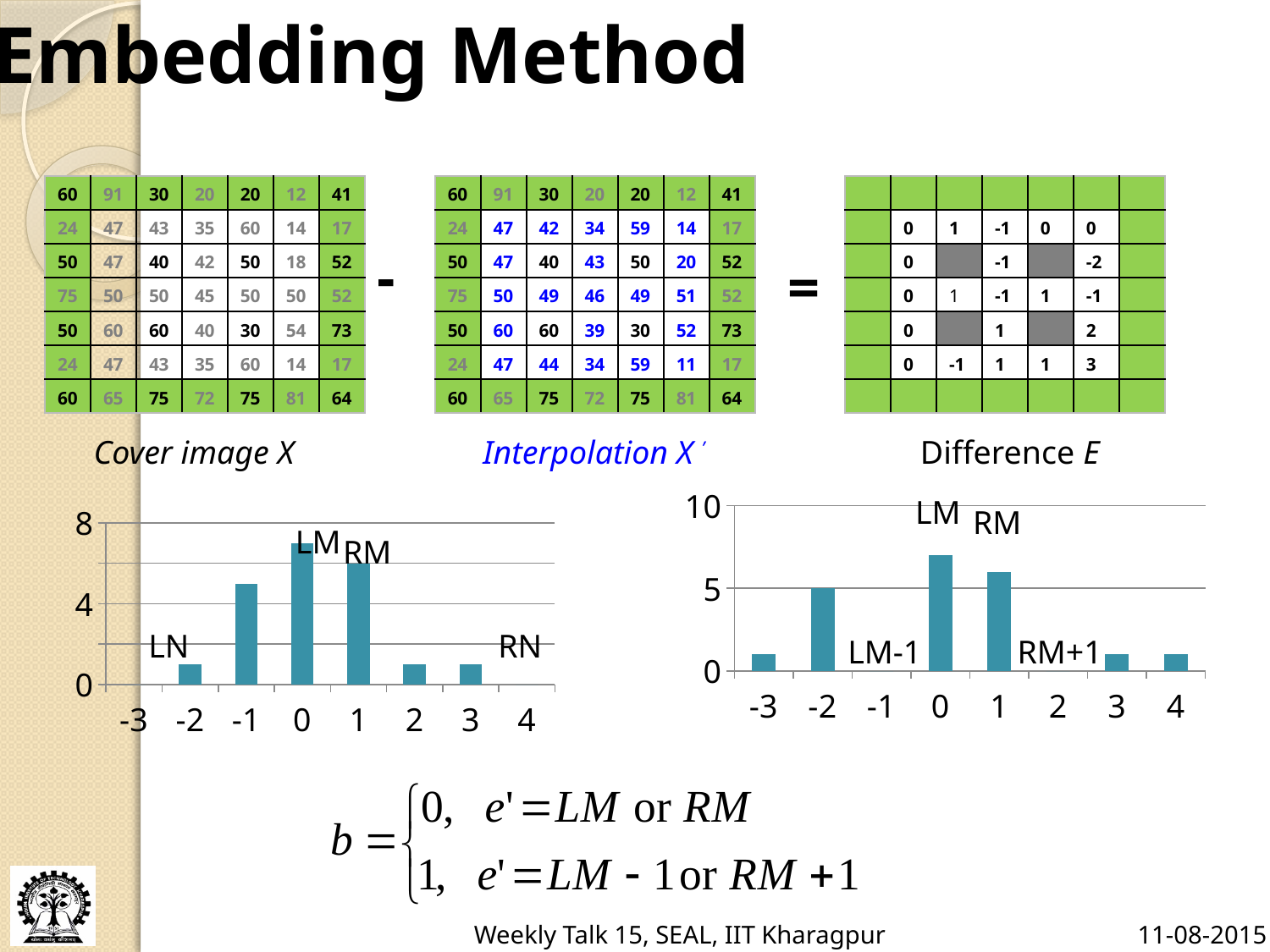
In the left chart (y-axis 0 to 8), is the bar at x = 0 greater or less than 4? greater In the right chart (y-axis 0 to 10), what is the value of the bar at x = -2? 5 In the right chart (y-axis 0 to 10), which bar is annotated with the label RM? 1 In the right chart (y-axis 0 to 10), which x-axis value has the tallest bar? 0 In the left chart (y-axis 0 to 8), which x-axis value has the tallest bar? 0 In the right chart (y-axis 0 to 10), how many bars are drawn? 6 In the left chart (y-axis 0 to 8), which bar is annotated with the label LM? 0 In the left chart (y-axis 0 to 8), is the bar at x = -2 greater or less than 4? less In the right chart (y-axis 0 to 10), which bar is taller, the one at x = -2 or the one at x = 1? 1 In the right chart (y-axis 0 to 10), is the bar at x = 0 greater or less than 5? greater In the left chart (y-axis 0 to 8), how many x-axis values are labelled along the axis? 8 What kind of chart is the left chart (with y-axis 0 to 8)? bar chart